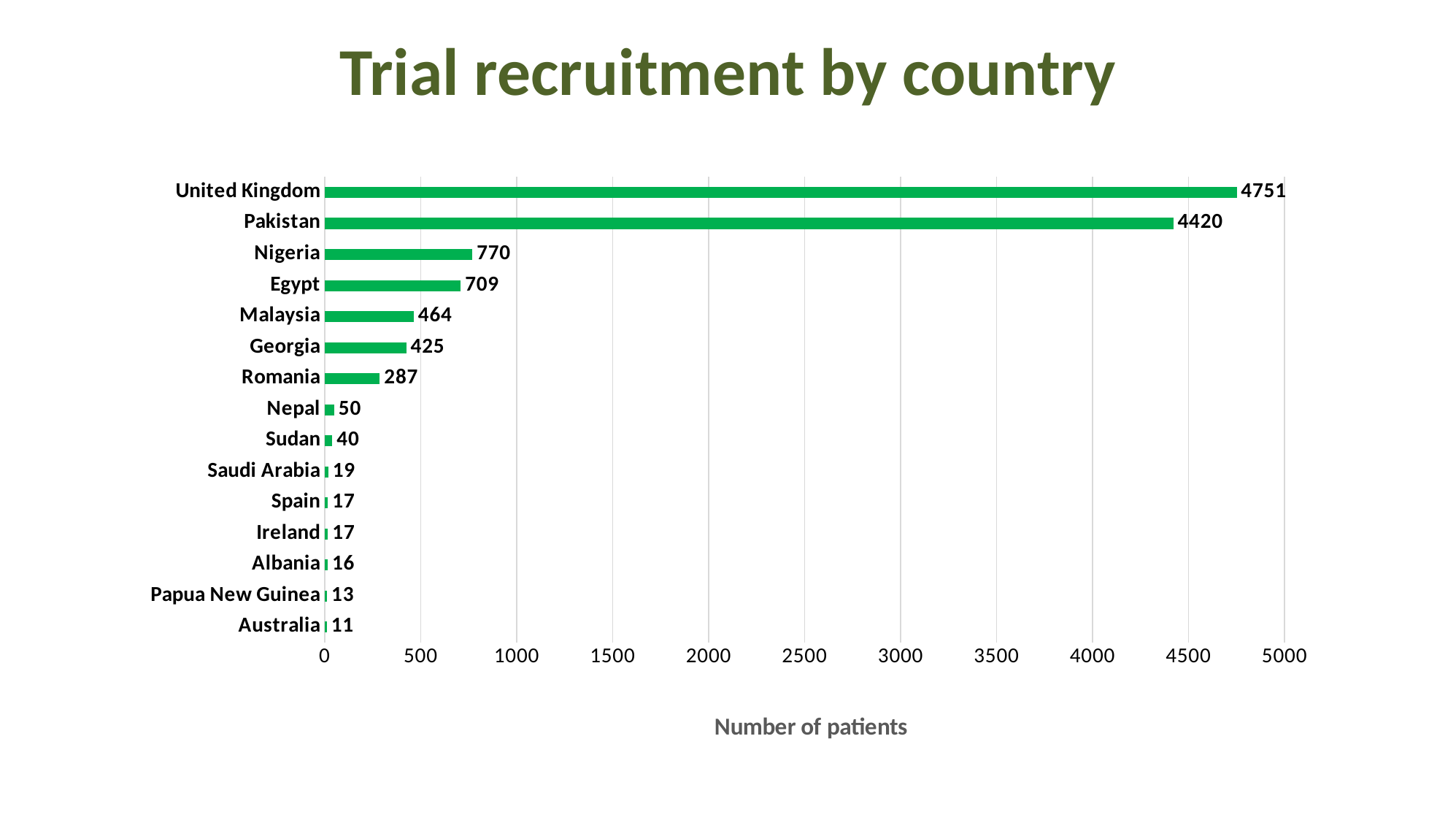
Which country recruited more patients, Georgia or Romania? Georgia Which country has the lowest number of patients recruited? Australia What is the number of patients recruited in Malaysia? 464 Which country has the highest number of patients recruited? United Kingdom How many countries are shown in the chart? 15 What is the difference in number of patients between Nigeria and Egypt? 61 What is the difference in number of patients between the United Kingdom and Pakistan? 331 What is the number of patients recruited in Papua New Guinea? 13 What is the label on the horizontal axis of the chart? Number of patients Is the value for Nigeria greater or less than 500? greater What kind of chart is shown on the slide? Bar chart What is the number of patients recruited in Pakistan? 4420